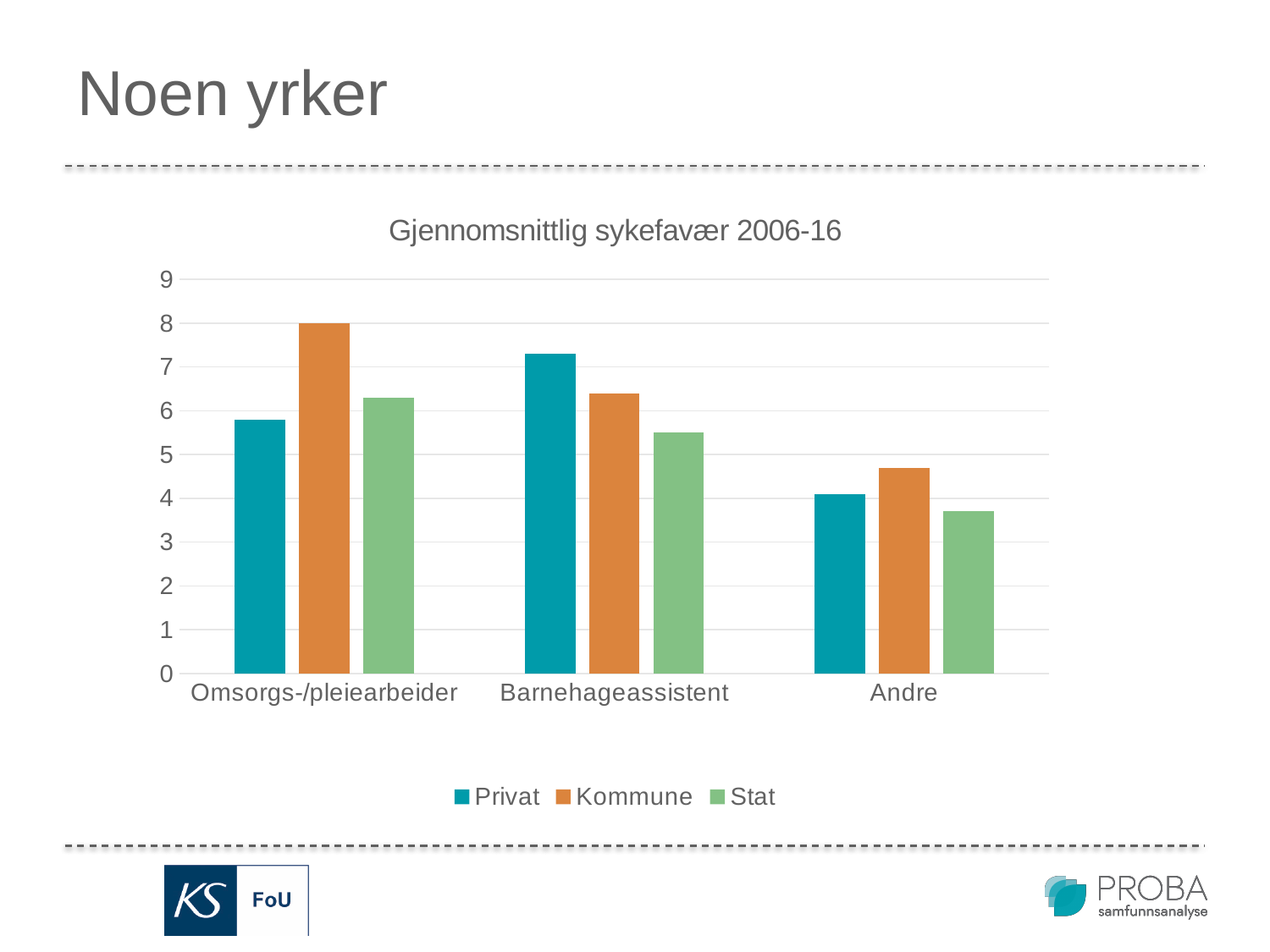
What is the title of the chart? Gjennomsnittlig sykefavær 2006-16 In the Omsorgs-/pleiearbeider category, which is larger: Privat or Stat? Stat How many series does the legend list? 3 Which category has the highest Kommune value? Omsorgs-/pleiearbeider How many categories are shown on the x axis? 3 What kind of chart is shown on the slide? bar chart Is the value for Privat in the Barnehageassistent category greater or less than 7? greater Which category has the lowest Stat value? Andre In the Barnehageassistent category, which is larger: Privat or Kommune? Privat Is the value for Kommune in the Andre category greater or less than 5? less What is the value for Kommune in the Omsorgs-/pleiearbeider category? 8 Is the value for Stat in the Andre category greater or less than 4? less